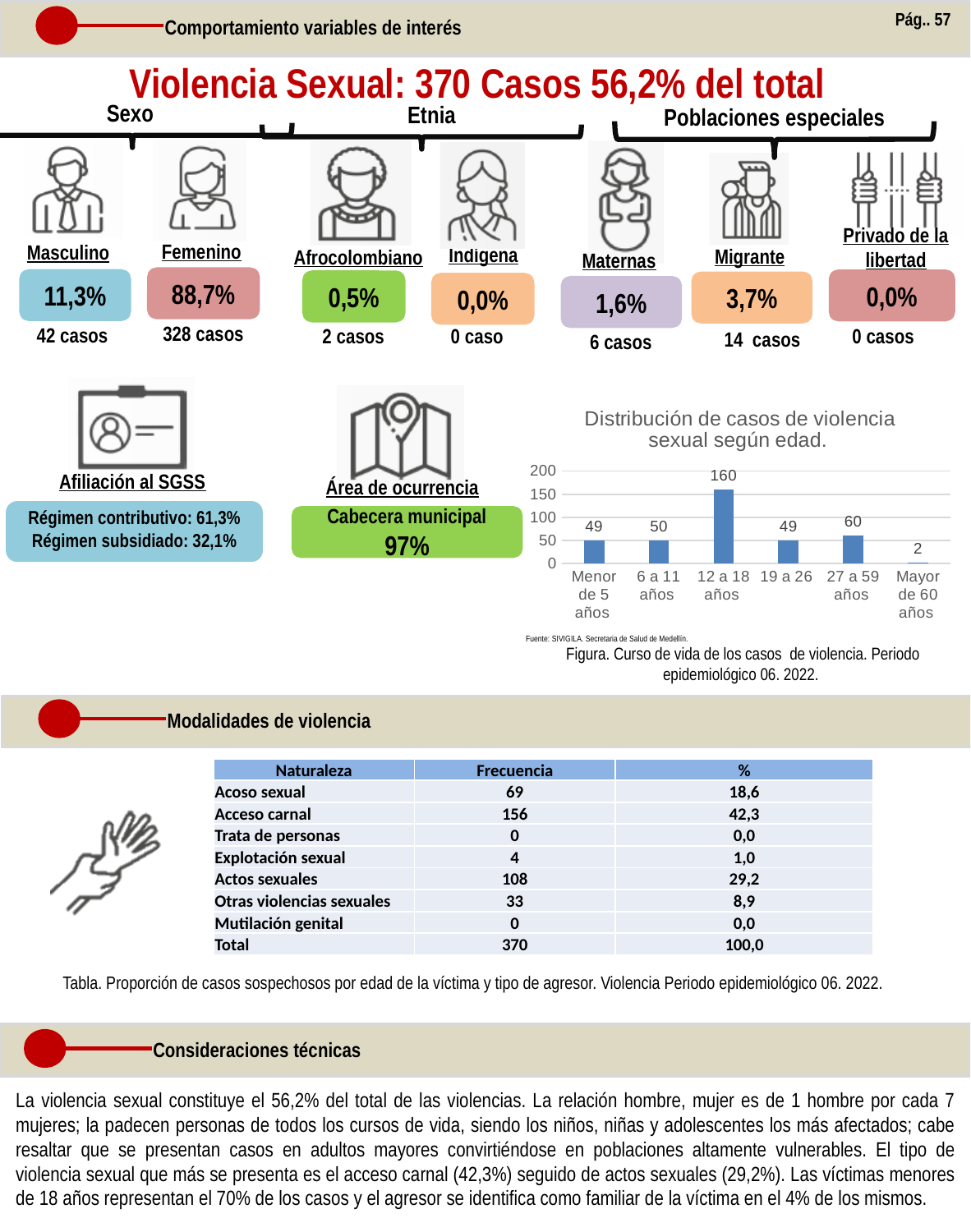
In the chart 'Distribución de casos de violencia sexual según edad', is the value for '12 a 18 años' greater or less than 150? greater In the chart 'Distribución de casos de violencia sexual según edad', what is the value for 'Mayor de 60 años'? 2 In the chart 'Distribución de casos de violencia sexual según edad', what is the value for '12 a 18 años'? 160 What kind of chart is 'Distribución de casos de violencia sexual según edad'? bar chart In the chart 'Distribución de casos de violencia sexual según edad', what is the difference between the values for '12 a 18 años' and '27 a 59 años'? 100 In the chart 'Distribución de casos de violencia sexual según edad', which age group has the lowest number of cases? Mayor de 60 años In the chart 'Distribución de casos de violencia sexual según edad', which age group has the highest number of cases? 12 a 18 años In the chart 'Distribución de casos de violencia sexual según edad', which is larger: the value for '27 a 59 años' or the value for '19 a 26'? 27 a 59 años In the chart 'Distribución de casos de violencia sexual según edad', what is the difference between the values for '6 a 11 años' and 'Menor de 5 años'? 1 In the chart 'Distribución de casos de violencia sexual según edad', what is the value for '27 a 59 años'? 60 How many age groups are shown in the chart 'Distribución de casos de violencia sexual según edad'? 6 In the chart 'Distribución de casos de violencia sexual según edad', what is the value for '6 a 11 años'? 50